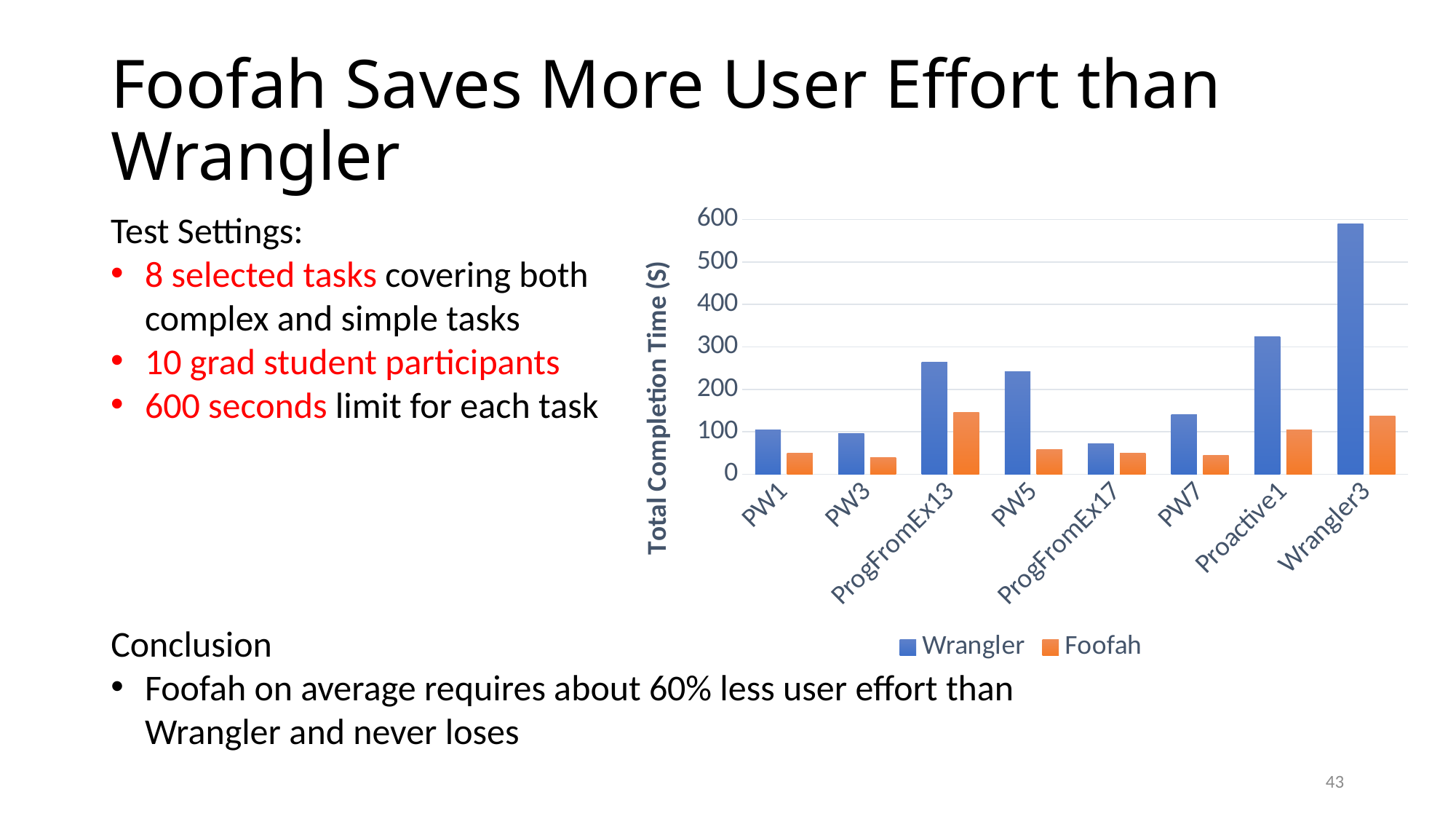
For PW5, which series has the larger total completion time, Wrangler or Foofah? Wrangler Is the Foofah value for PW1 greater or less than 100? less Which task has the highest Wrangler total completion time? Wrangler3 How many series does the chart legend list? 2 Which task has the lowest Wrangler total completion time? ProgFromEx17 What is the label of the y axis of the chart? Total Completion Time (S) What kind of chart is shown on the slide? bar chart Is the Wrangler value for ProgFromEx17 greater or less than 100? less Is the Wrangler value for Proactive1 greater or less than 300? greater How many task categories are shown on the x axis of the chart? 8